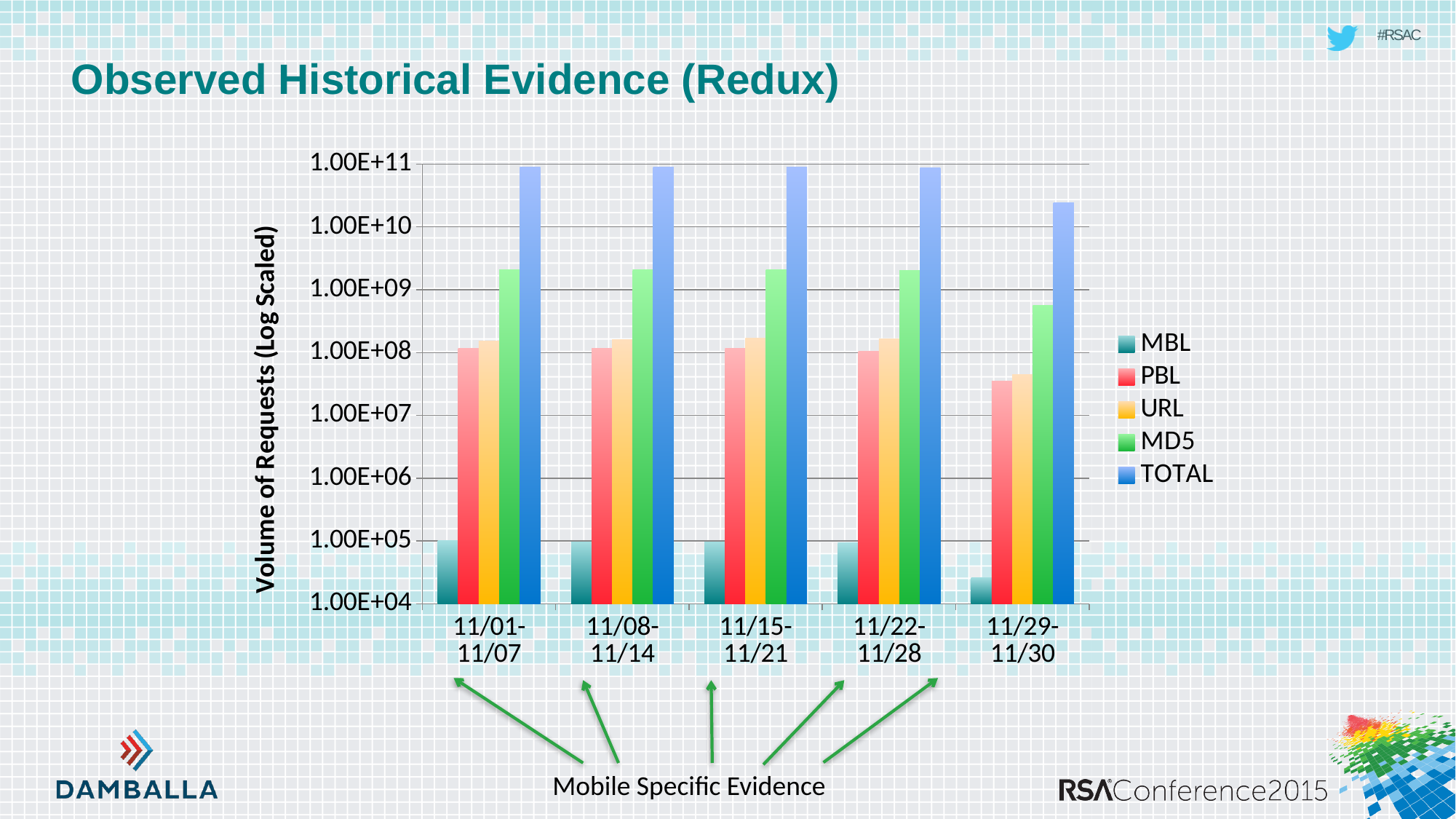
How many series does the legend list? 5 Which series has the highest value in the 11/01-11/07 period? TOTAL In the 11/22-11/28 period, which is larger: the MD5 value or the URL value? MD5 Is the MD5 value for 11/29-11/30 greater or less than 1.00E+09? less How many date-range categories are shown on the x axis? 5 What is the label of the y axis? Volume of Requests (Log Scaled) Is the TOTAL value for 11/01-11/07 greater or less than 1.00E+10? greater What kind of chart is shown on the slide? bar chart Does the TOTAL value rise or fall from the 11/22-11/28 period to the 11/29-11/30 period? fall Which series has the lowest value in the 11/15-11/21 period? MBL Is the PBL value for 11/08-11/14 greater or less than 1.00E+07? greater